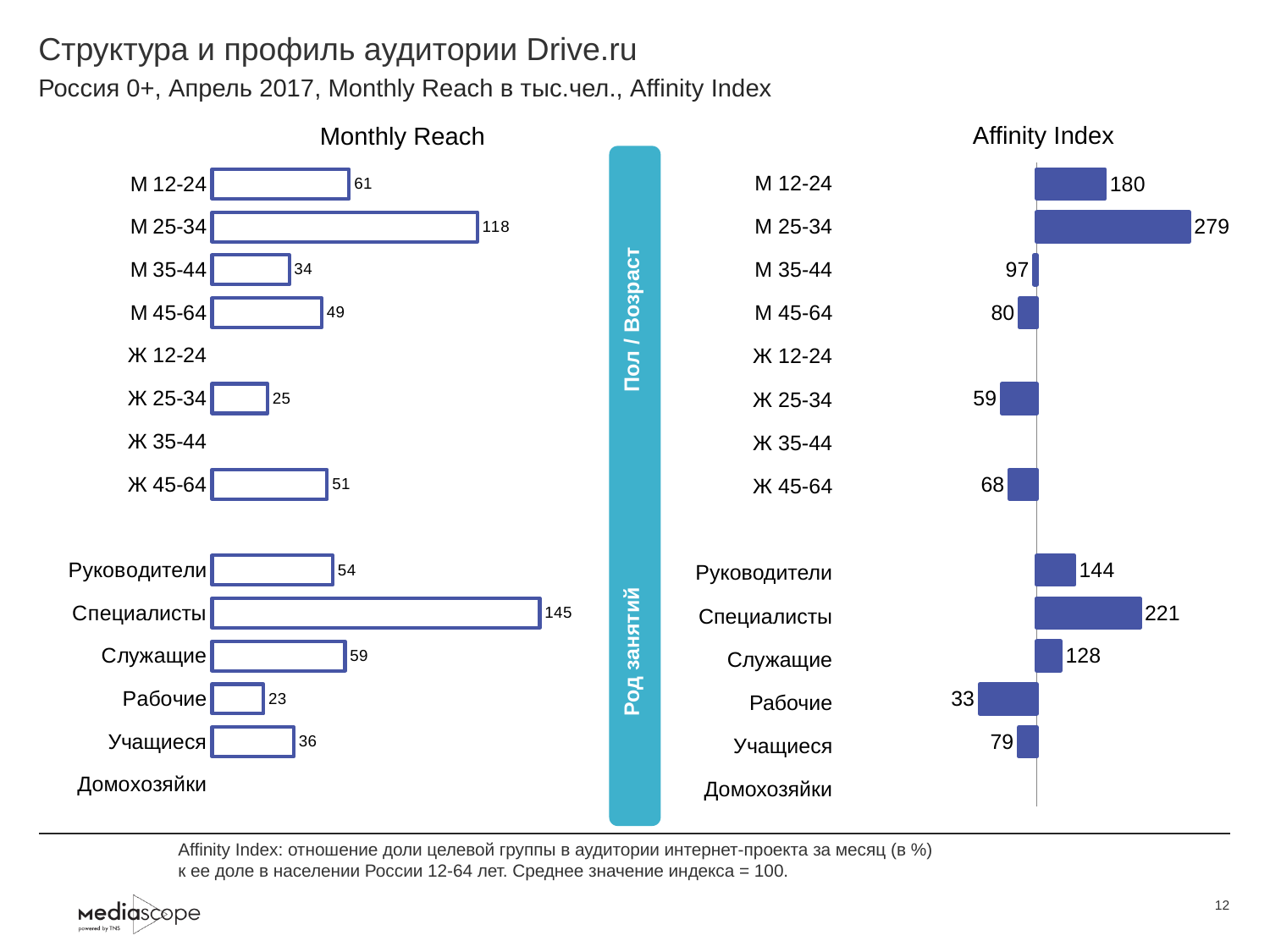
In the Affinity Index chart, what is the value for М 35-44? 97 In the Monthly Reach chart, what is the value for Рабочие? 23 In the Affinity Index chart, what is the difference between the values for М 25-34 and М 12-24? 99 In the Monthly Reach chart, which is larger: the value for Служащие or the value for Руководители? Служащие In the Affinity Index chart, which category has the lowest value among those with a bar? Рабочие In the Monthly Reach chart, what is the value for М 25-34? 118 In the Monthly Reach chart, what is the difference between the values for М 25-34 and М 12-24? 57 In the Affinity Index chart, which is larger: the value for Ж 45-64 or the value for Ж 25-34? Ж 45-64 In the Affinity Index chart, which category has the highest value? М 25-34 In the Monthly Reach chart, which category has the highest value? Специалисты In the Affinity Index chart, what is the value for Специалисты? 221 What type of chart is the Affinity Index chart? Bar chart